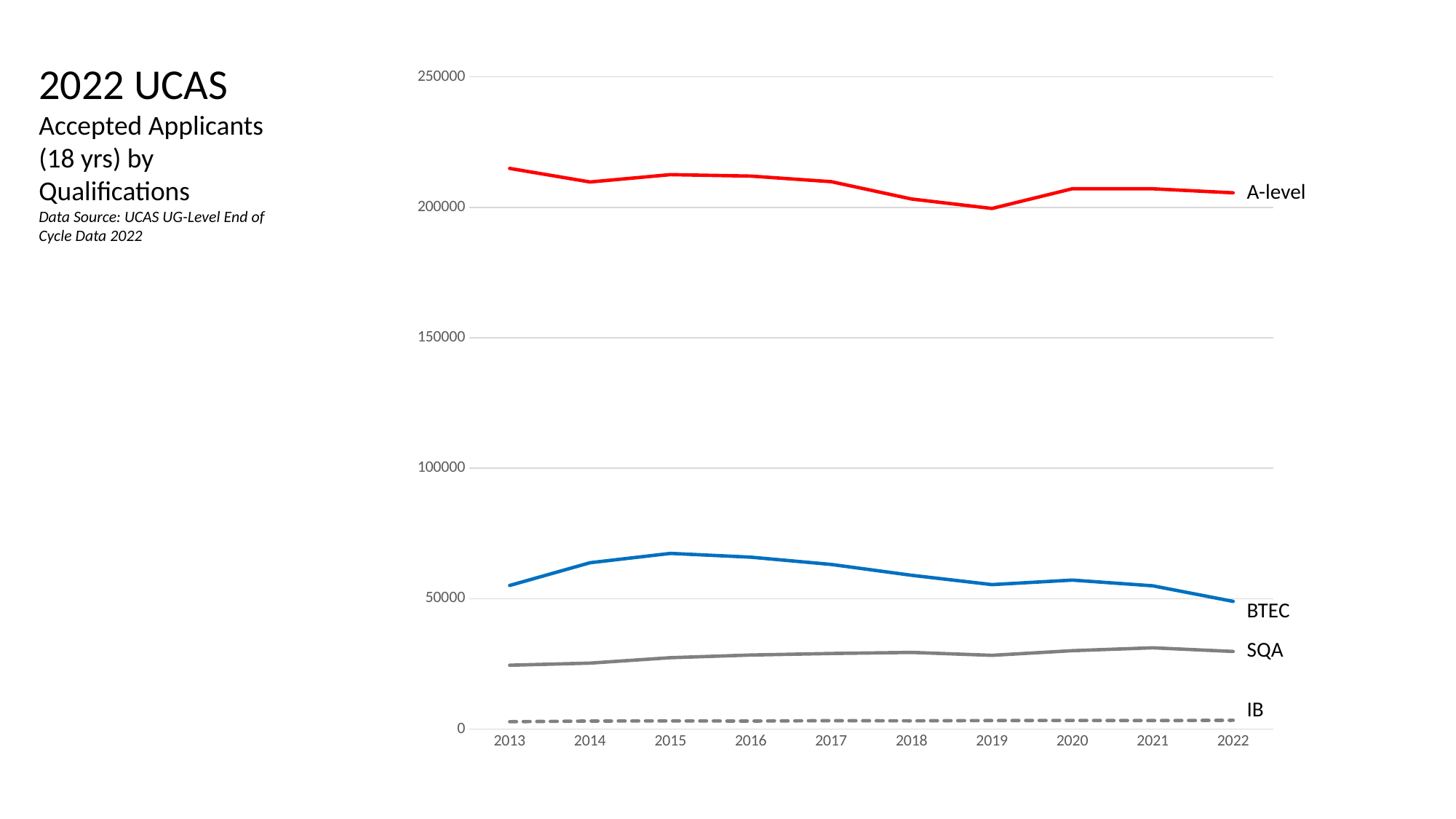
Which series is drawn with a dashed line? IB Is the value for A-level in 2013 greater or less than 200000? greater Does the BTEC line rise or fall from 2015 to 2022? fall Is the value for SQA in 2022 greater or less than 50000? less Is the value for BTEC in 2015 greater or less than 50000? greater In which year does the A-level line reach its lowest point? 2019 In 2015, which is larger: BTEC or SQA? BTEC Which qualification has the highest number of accepted applicants across all years? A-level How many years are shown along the x axis? 10 How many series (qualification types) are plotted on the chart? 4 Which qualification has the lowest number of accepted applicants across all years? IB What kind of chart is shown on the slide? line chart